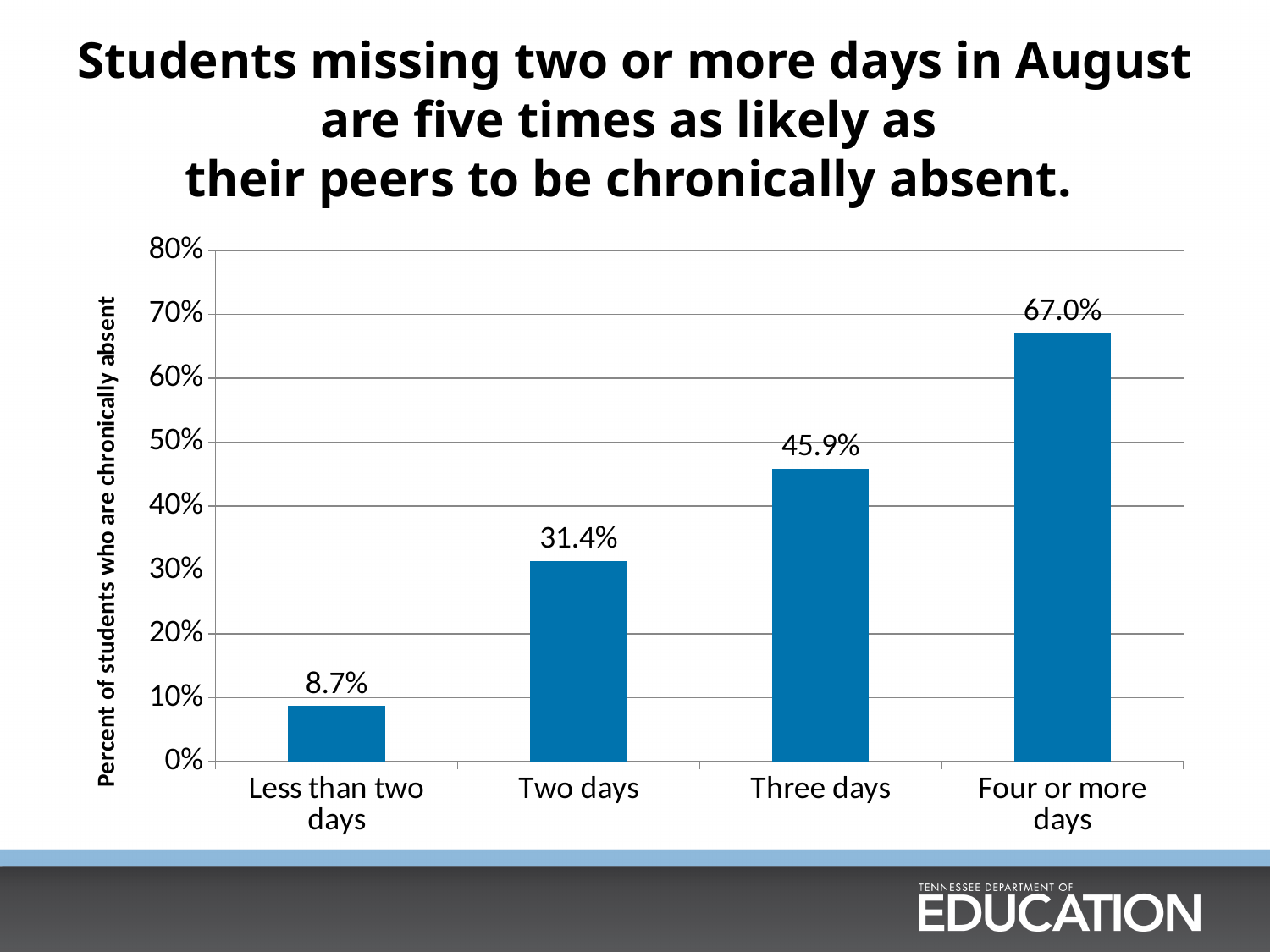
What is the difference in percentage points between the 'Three days' and 'Two days' categories? 14.5 What is the value for the 'Three days' category? 45.9% What is the value for the 'Four or more days' category? 67.0% What is the value for the 'Less than two days' category? 8.7% Which category has the lowest percent of students who are chronically absent? Less than two days What percent of students who missed two days in August are chronically absent? 31.4% How many categories are shown on the x axis? 4 What kind of chart is shown on the slide? Bar chart Which is larger, the value for 'Two days' or the value for 'Three days'? Three days Do the values rise or fall as you move from left to right along the x axis? Rise Which category has the highest percent of students who are chronically absent? Four or more days What is the difference in percentage points between the 'Four or more days' and 'Less than two days' categories? 58.3